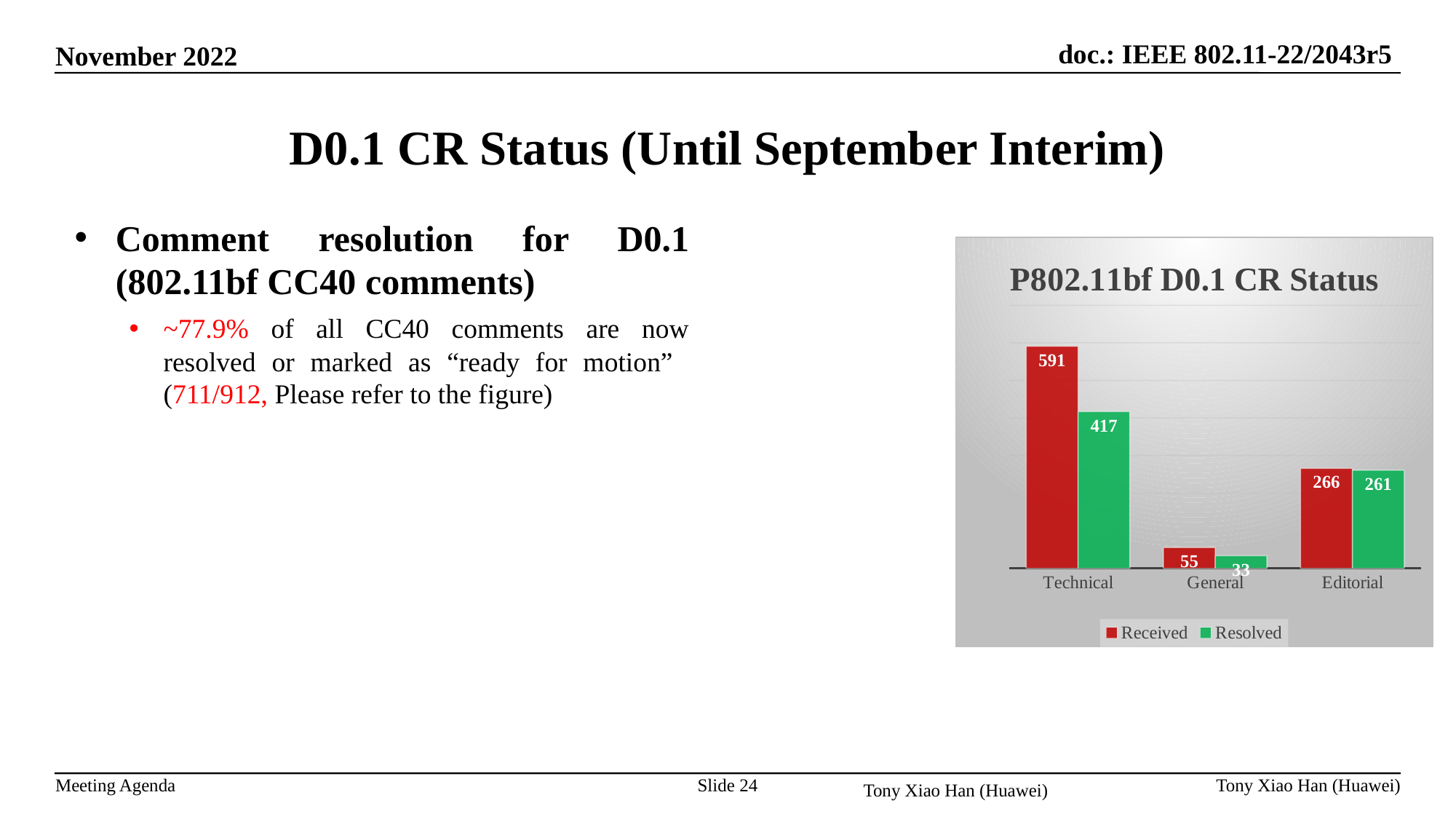
Which category has the lowest Resolved value? General How many series does the legend list? 2 What is the Resolved value for Technical? 417 What is the Received value for Technical in the P802.11bf D0.1 CR Status chart? 591 What type of chart is shown on the slide? Bar chart What is the difference between Received and Resolved for Technical? 174 How many categories are shown on the x axis? 3 What is the Received value for General? 55 What is the Resolved value for Editorial? 261 Which is larger for General: Received or Resolved? Received What is the difference between Received and Resolved for Editorial? 5 Which category has the highest Received value? Technical